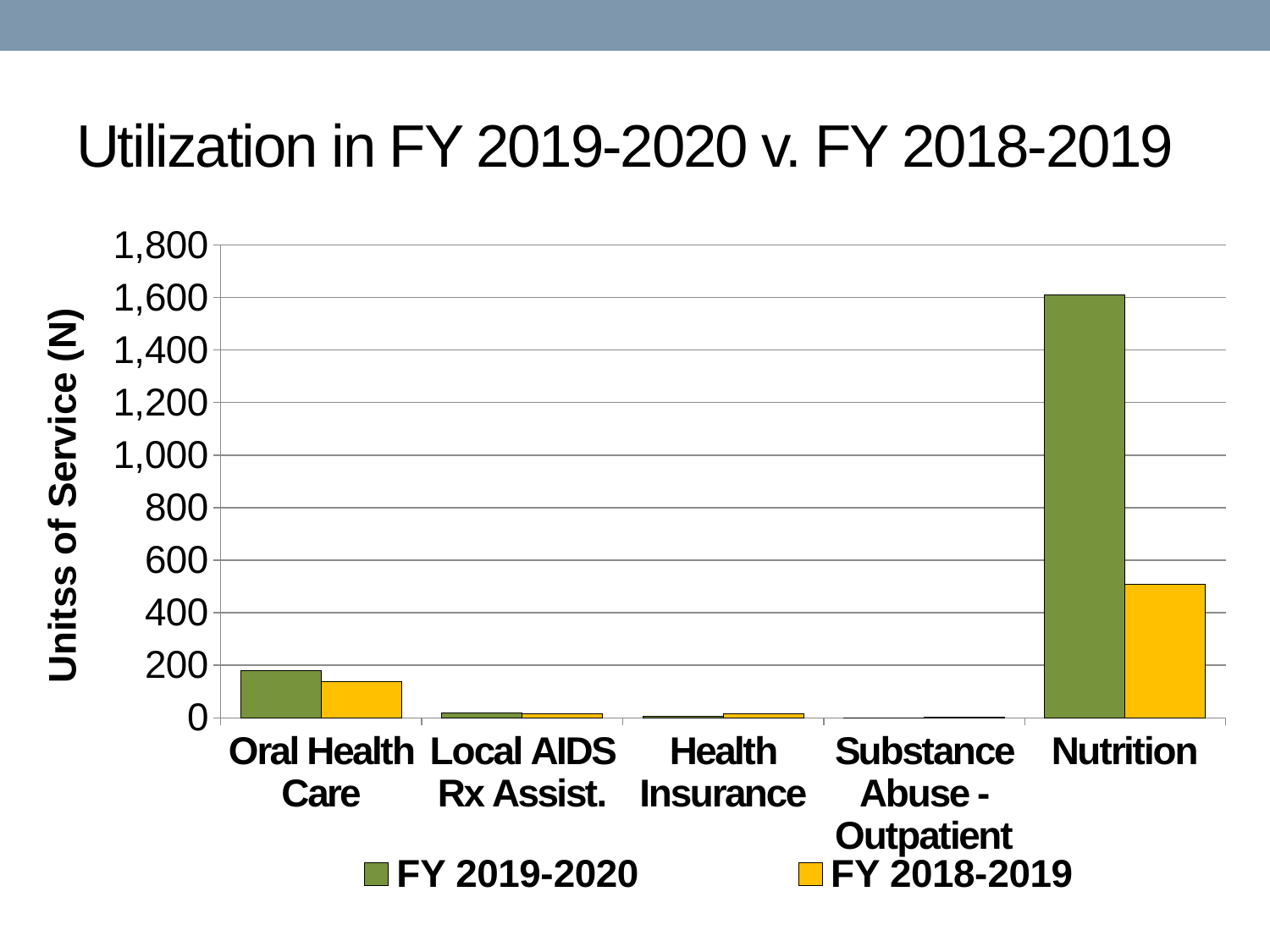
Is the FY 2019-2020 value for Nutrition greater or less than 1,400? greater Which category has the lowest FY 2019-2020 value? Substance Abuse - Outpatient Which category has the highest FY 2019-2020 value? Nutrition For Nutrition, which is larger: the FY 2019-2020 value or the FY 2018-2019 value? FY 2019-2020 Is the FY 2018-2019 value for Nutrition greater or less than 600? less For Oral Health Care, which is larger: the FY 2019-2020 value or the FY 2018-2019 value? FY 2019-2020 What kind of chart is shown on the slide? bar chart Which category has the highest FY 2018-2019 value? Nutrition What is the title of the chart? Utilization in FY 2019-2020 v. FY 2018-2019 How many service categories are shown on the x axis? 5 How many series does the legend list? 2 Is the FY 2019-2020 value for Oral Health Care greater or less than 200? less